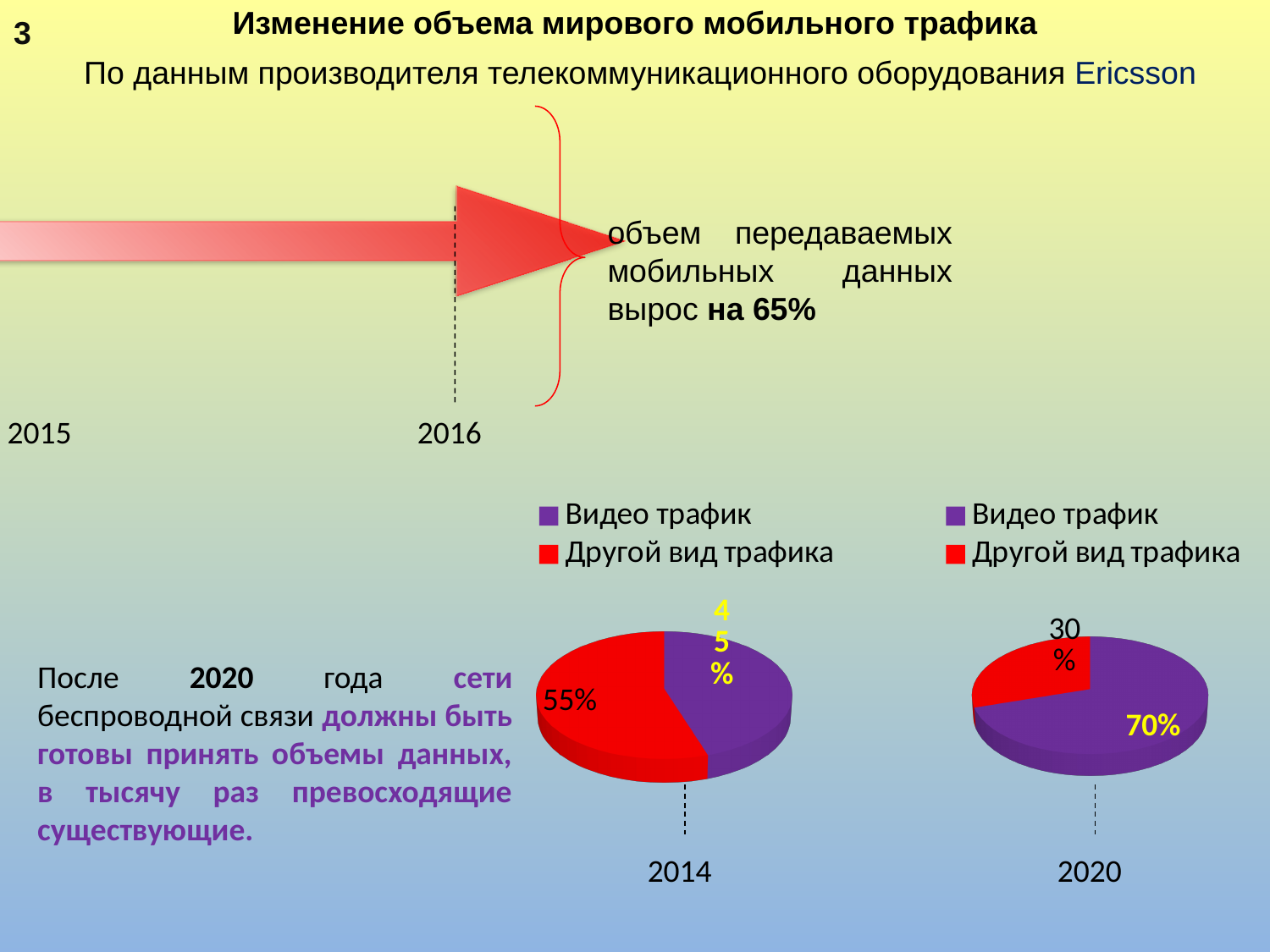
In the 2014 pie chart, what share does Другой вид трафика have? 55% Is the Видео трафик share larger in the 2014 pie chart or in the 2020 pie chart? 2020 How many entries does the legend of the 2020 pie chart list? 2 In the 2014 pie chart, which slice is larger? Другой вид трафика What is the difference between the Видео трафик share in the 2020 pie chart and in the 2014 pie chart? 25% In the 2014 pie chart, what colour is the Видео трафик slice? Purple What type of chart is used for the 2014 and 2020 traffic data? Pie chart In the 2020 pie chart, which slice is smaller? Другой вид трафика In the 2020 pie chart, what share does Видео трафик have? 70% In the 2020 pie chart, what is the difference between the Видео трафик and Другой вид трафика shares? 40% In the 2014 pie chart, what share does Видео трафик have? 45% In the 2020 pie chart, what share does Другой вид трафика have? 30%